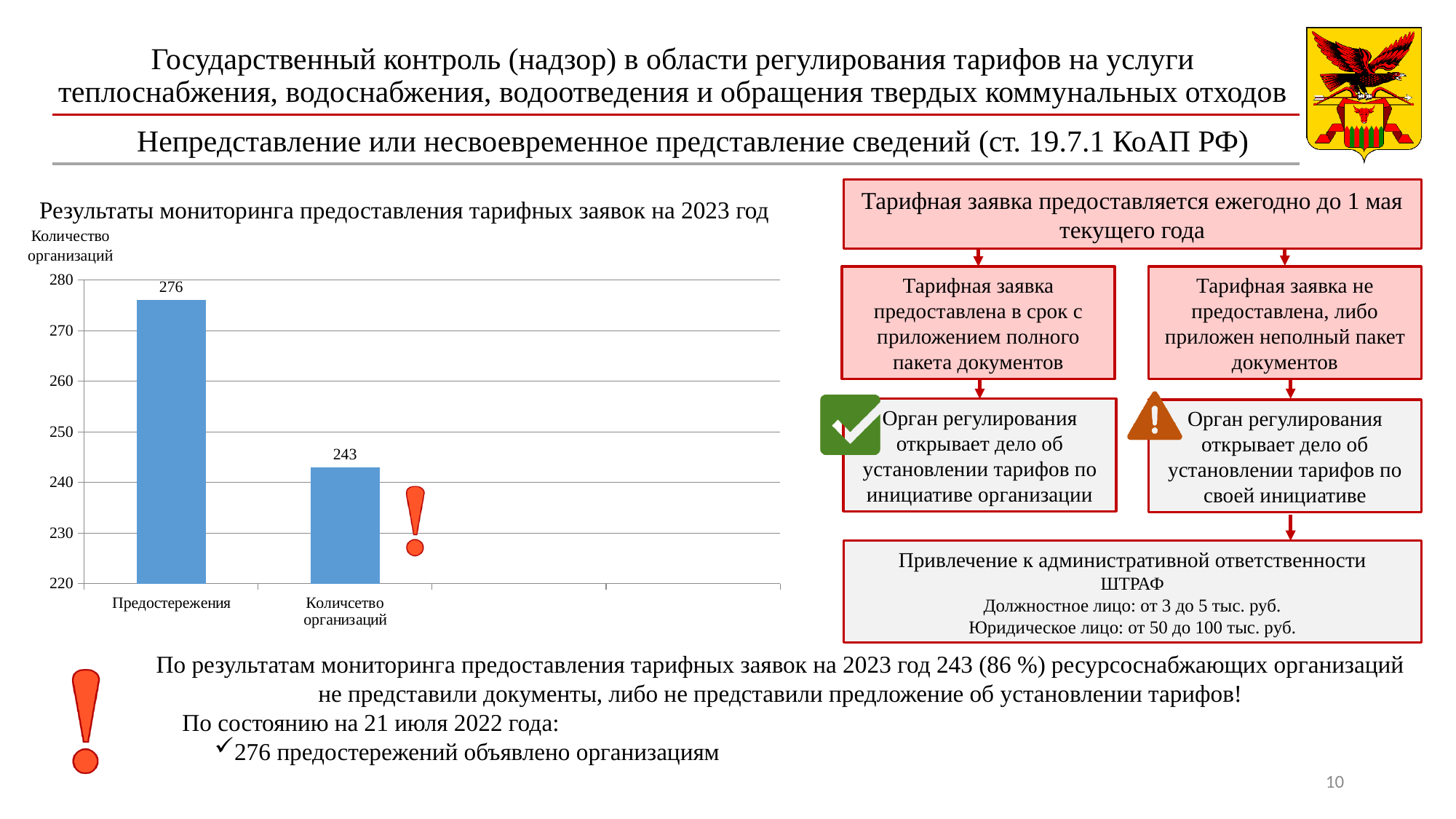
What is the title of the chart? Результаты мониторинга предоставления тарифных заявок на 2023 год Which category has the lowest value in the chart? Количсетво организаций Which category has the highest value in the chart? Предостережения Which is larger: the value for Предостережения or the value for Количсетво организаций? Предостережения What kind of chart is shown on the slide? bar chart What is the label of the vertical axis of the chart? Количество организаций Is the value for Количсетво организаций greater or less than 250? less What is the value for Предостережения in the chart? 276 Is the value for Предостережения greater or less than 270? greater What is the difference between the values for Предостережения and Количсетво организаций? 33 How many categories are shown in the chart? 2 What is the value for Количсетво организаций in the chart? 243